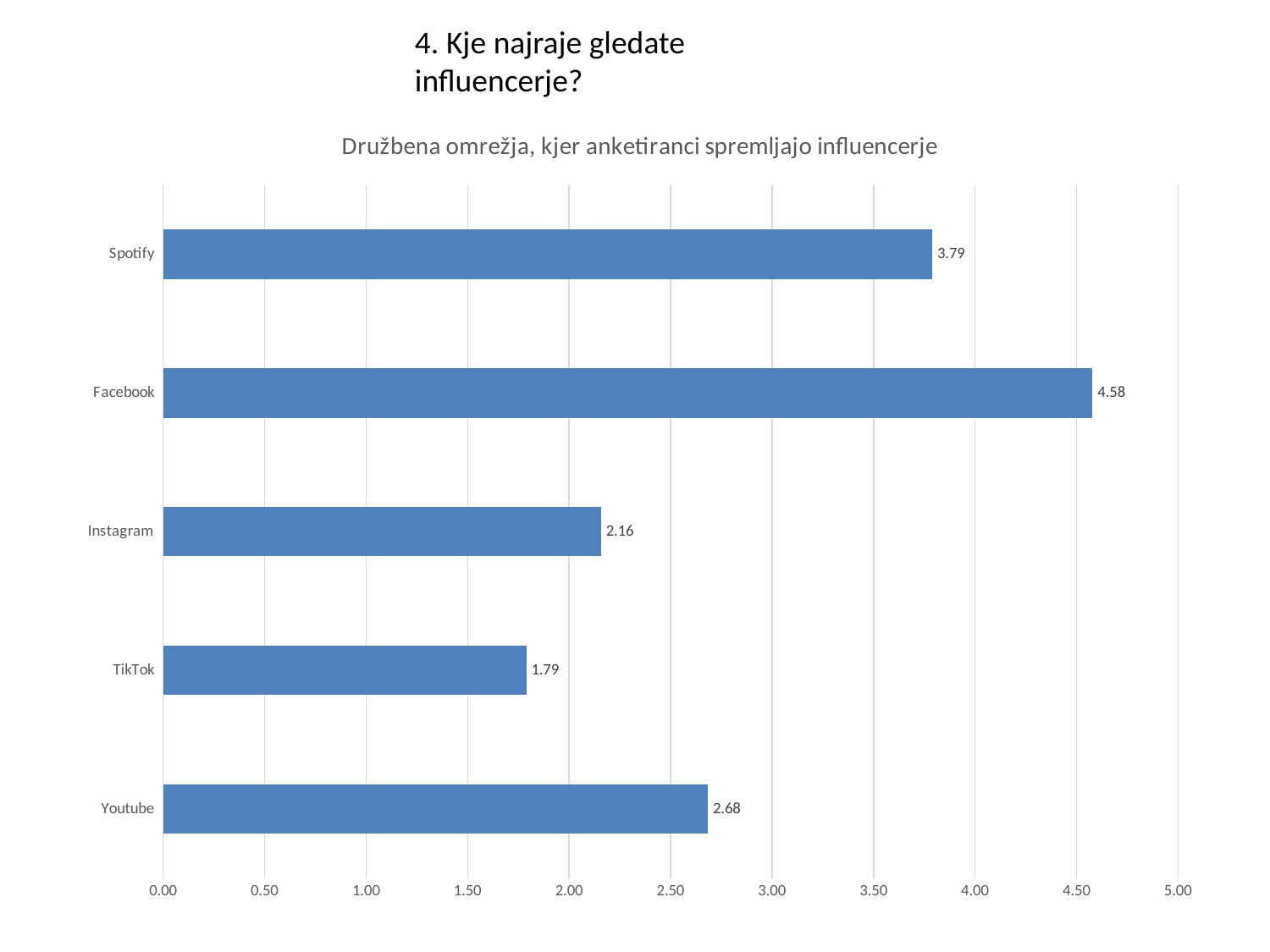
Is the value for Spotify greater or less than 3.50? greater How many categories are shown in the chart? 5 What is the value for Facebook? 4.58 Which category has the highest value? Facebook What is the difference between the values for Facebook and Spotify? 0.79 What kind of chart is shown on the slide? bar chart What is the value for Youtube? 2.68 What is the title of the chart? Družbena omrežja, kjer anketiranci spremljajo influencerje What is the highest value shown on the horizontal axis? 5.00 Which is larger, the value for Instagram or the value for Youtube? Youtube Which category has the lowest value? TikTok What is the value for TikTok? 1.79